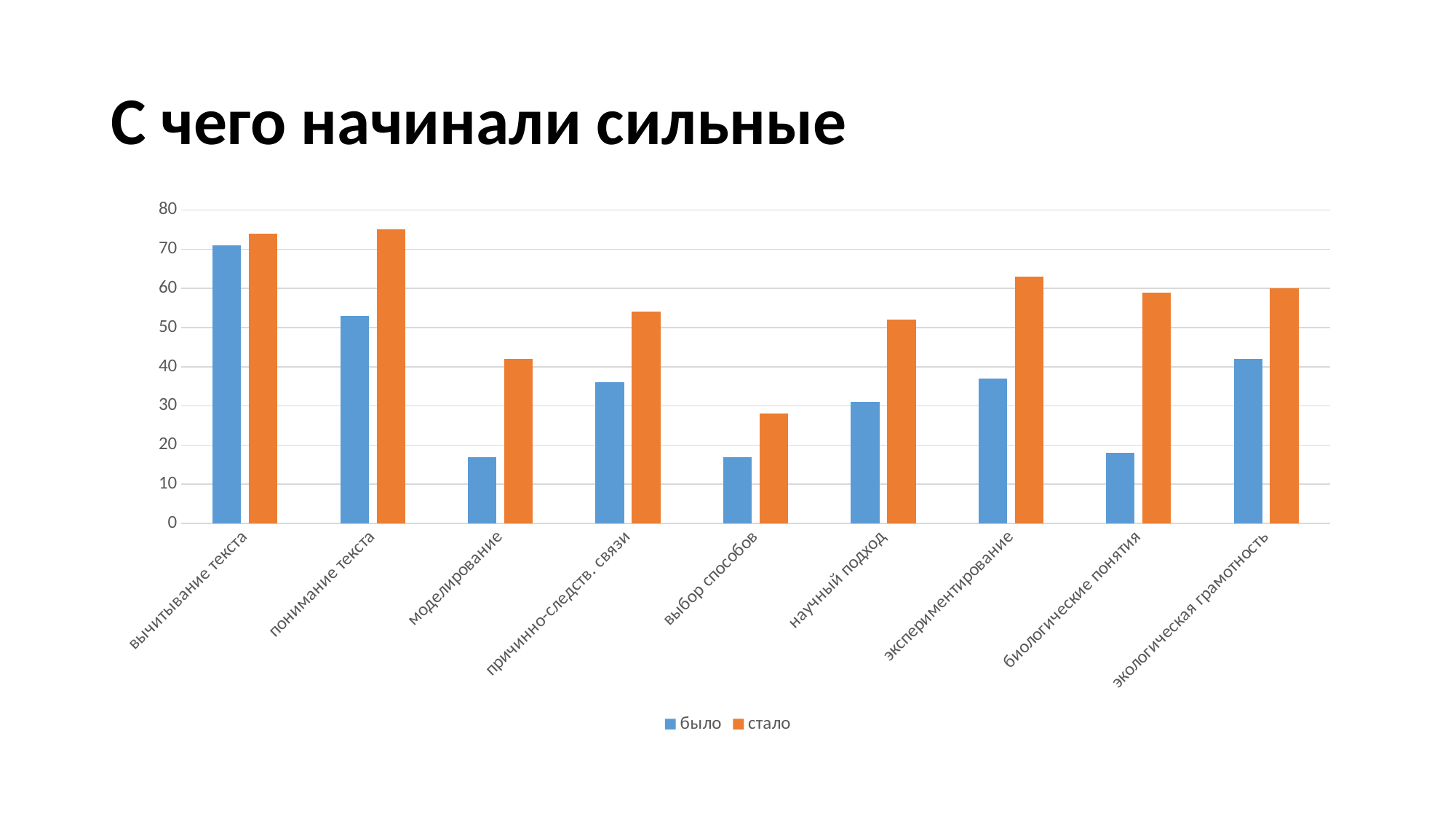
Is the value of "было" for "биологические понятия" greater or less than 20? less Which series is shown in orange in the legend? стало Is the value of "было" for "понимание текста" greater or less than 50? greater What is the title of the slide above the chart? С чего начинали сильные For "биологические понятия", which series has the larger value, "было" or "стало"? стало What kind of chart is shown on the slide? bar chart Which category has the lowest value for the series "стало"? выбор способов How many series does the legend list? 2 How many categories are shown on the x axis of the chart? 9 Is the value of "стало" for "экспериментирование" greater or less than 60? greater For the series "было", which is larger: "экологическая грамотность" or "научный подход"? экологическая грамотность Which category has the highest value for the series "было"? вычитывание текста